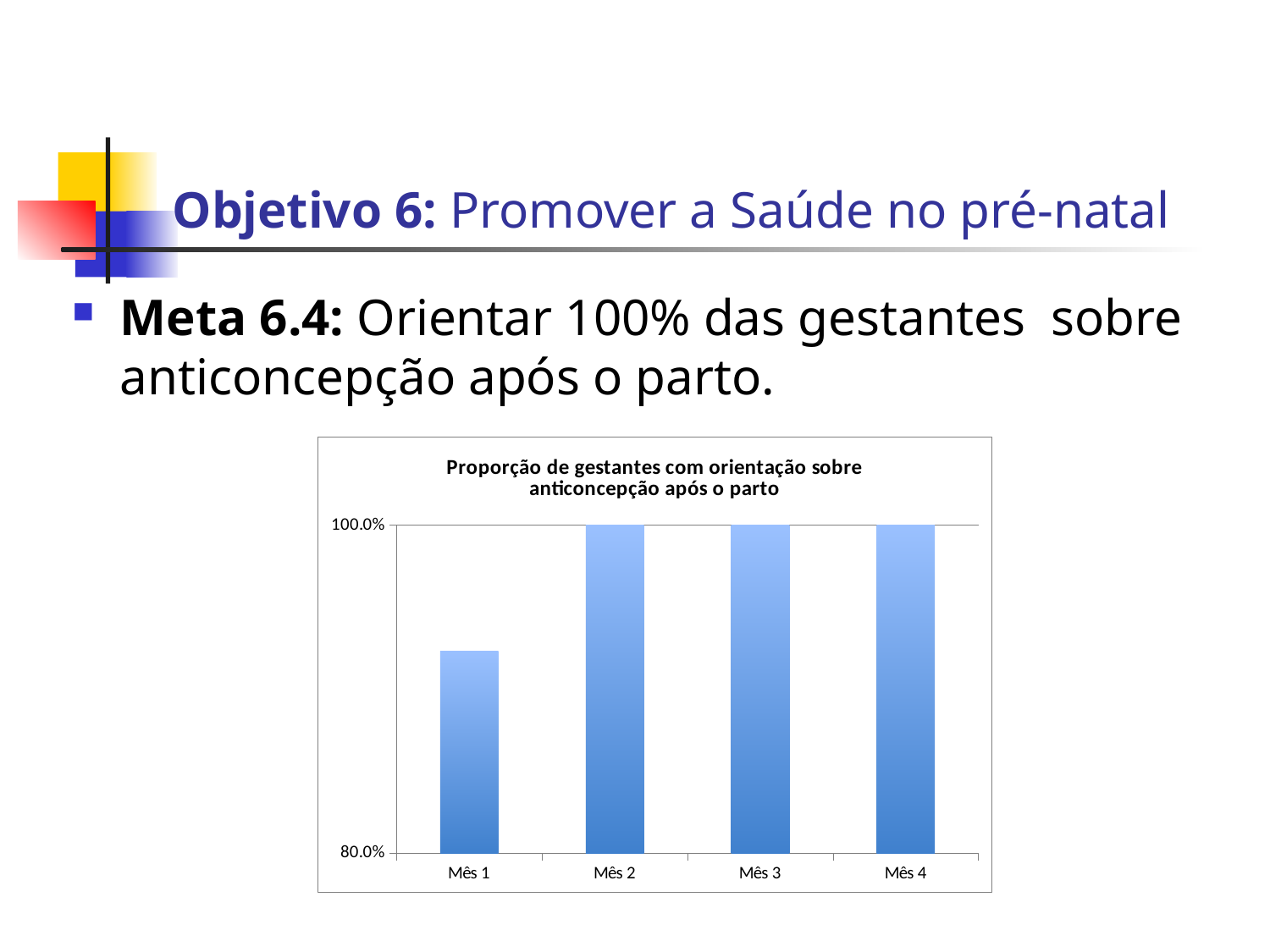
What is the value for Mês 2 in the chart? 100.0% What kind of chart is shown on the slide? bar chart Does the value rise or fall from Mês 1 to Mês 2? rise What is the value for Mês 3 in the chart? 100.0% What is the value for Mês 4 in the chart? 100.0% Is the value for Mês 1 greater or less than 100.0%? less How many categories (months) are shown on the x axis of the chart? 4 What is the lowest value shown on the y axis of the chart? 80.0% Which is larger, the value for Mês 1 or the value for Mês 2? Mês 2 Is the value for Mês 1 greater or less than 80.0%? greater What is the title of the chart? Proporção de gestantes com orientação sobre anticoncepção após o parto Which month has the lowest value in the chart? Mês 1